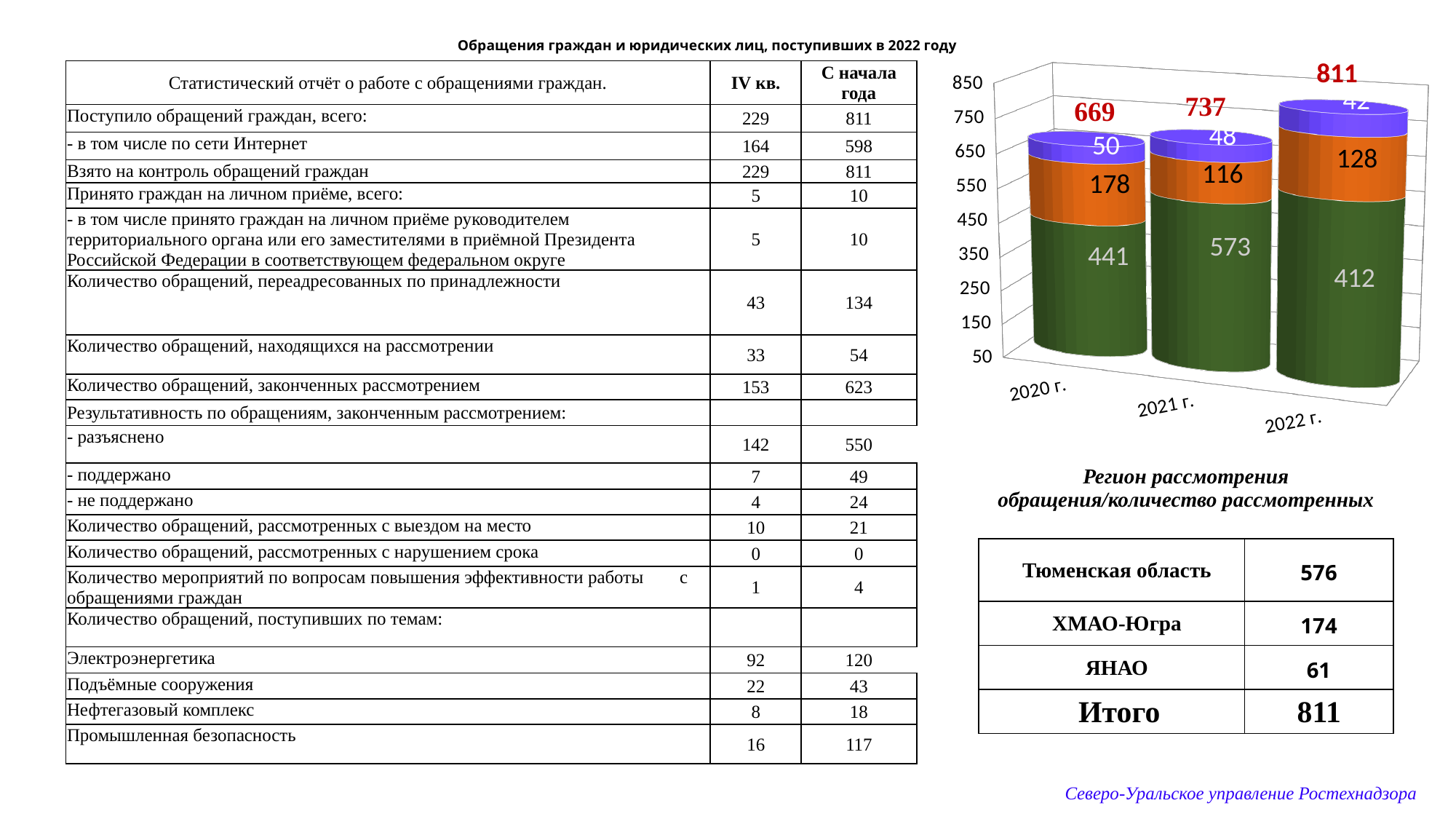
Which year has the lowest total in the chart? 2020 г. What is the total value shown above the bar for 2021 г.? 737 What is the difference between the totals for 2022 г. and 2020 г.? 142 What is the value of the green (bottom) segment for 2021 г.? 573 Which is larger: the orange segment for 2020 г. or the orange segment for 2022 г.? 2020 г. How many years are shown on the x axis of the chart? 3 What is the total value shown above the bar for 2020 г.? 669 Do the totals rise or fall from 2020 г. to 2022 г.? rise What is the total value shown above the bar for 2022 г.? 811 Which year has the highest total in the chart? 2022 г. What is the value of the purple (top) segment for 2020 г.? 50 What is the value of the orange (middle) segment for 2020 г.? 178